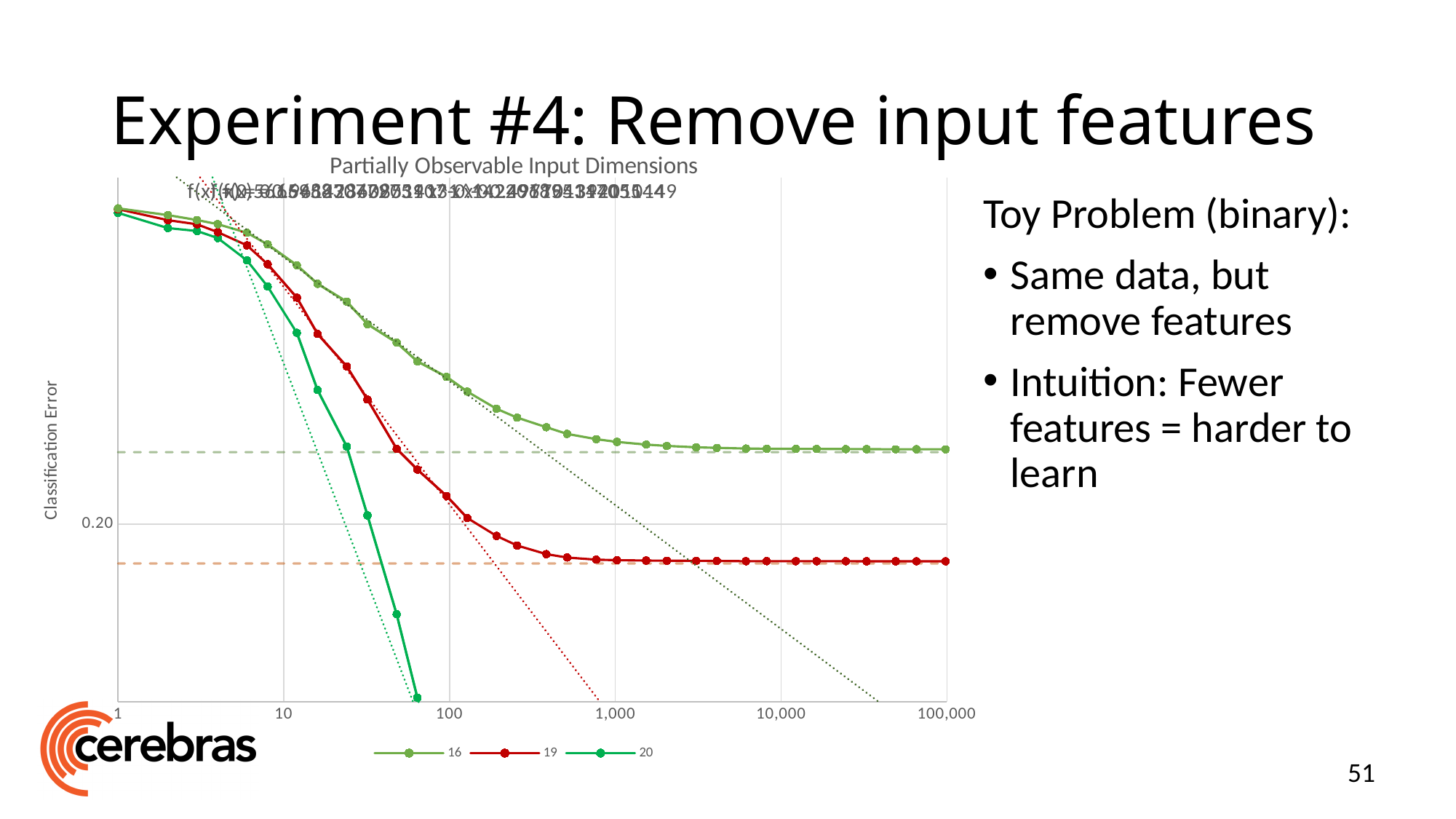
How many series does the chart's legend list? 3 At x = 1,000, which series has the larger classification error, 16 or 19? 16 What are the series names listed in the chart's legend? 16, 19, 20 Does the classification error for series 16 rise or fall as the x axis increases? fall Which series has the lowest classification error at x = 10? 20 Does the classification error for series 19 rise or fall as the x axis increases? fall What kind of chart is shown on the slide? line chart Which series has the highest classification error at x = 100,000? 16 At x = 10, which series has the larger classification error, 19 or 20? 19 At x = 100,000, is the classification error for series 16 greater or less than 0.20? greater What is the title of the chart? Partially Observable Input Dimensions At x = 100,000, is the classification error for series 19 greater or less than 0.20? less